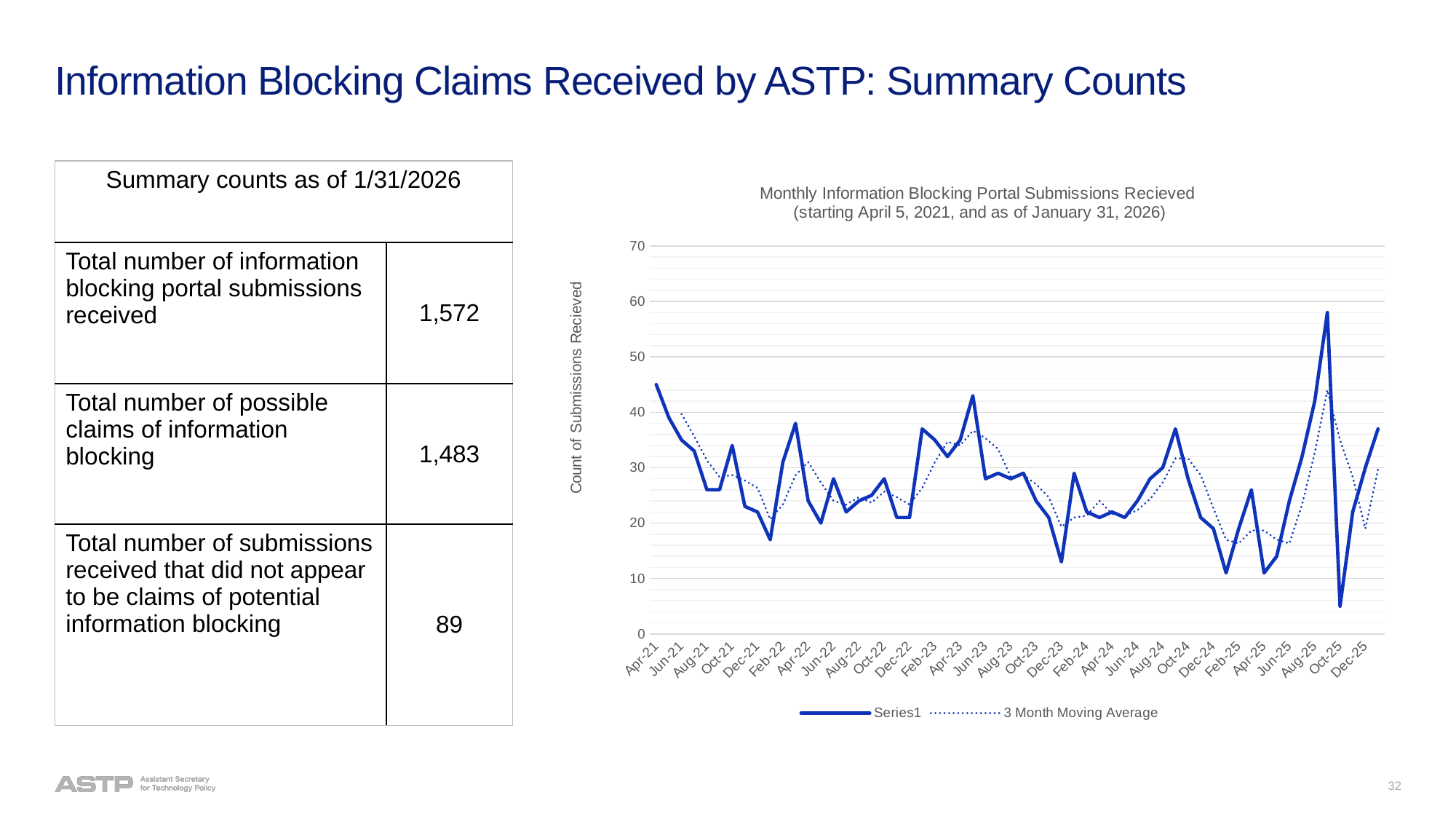
Is the Series1 value for Dec-23 greater or less than 20? less How many series does the chart legend list? 2 Which month has the lowest value for Series1? Oct-25 Is the Series1 value for Oct-21 greater or less than 30? greater Is the Series1 value for Apr-21 greater or less than 40? greater What kind of chart is shown on the slide? line chart Which is larger, the Series1 value for Apr-21 or for Dec-23? Apr-21 What is the label on the chart's vertical axis? Count of Submissions Recieved Does the Series1 line rise or fall from Apr-21 to Aug-21? fall What are the two series named in the chart legend? Series1 and 3 Month Moving Average